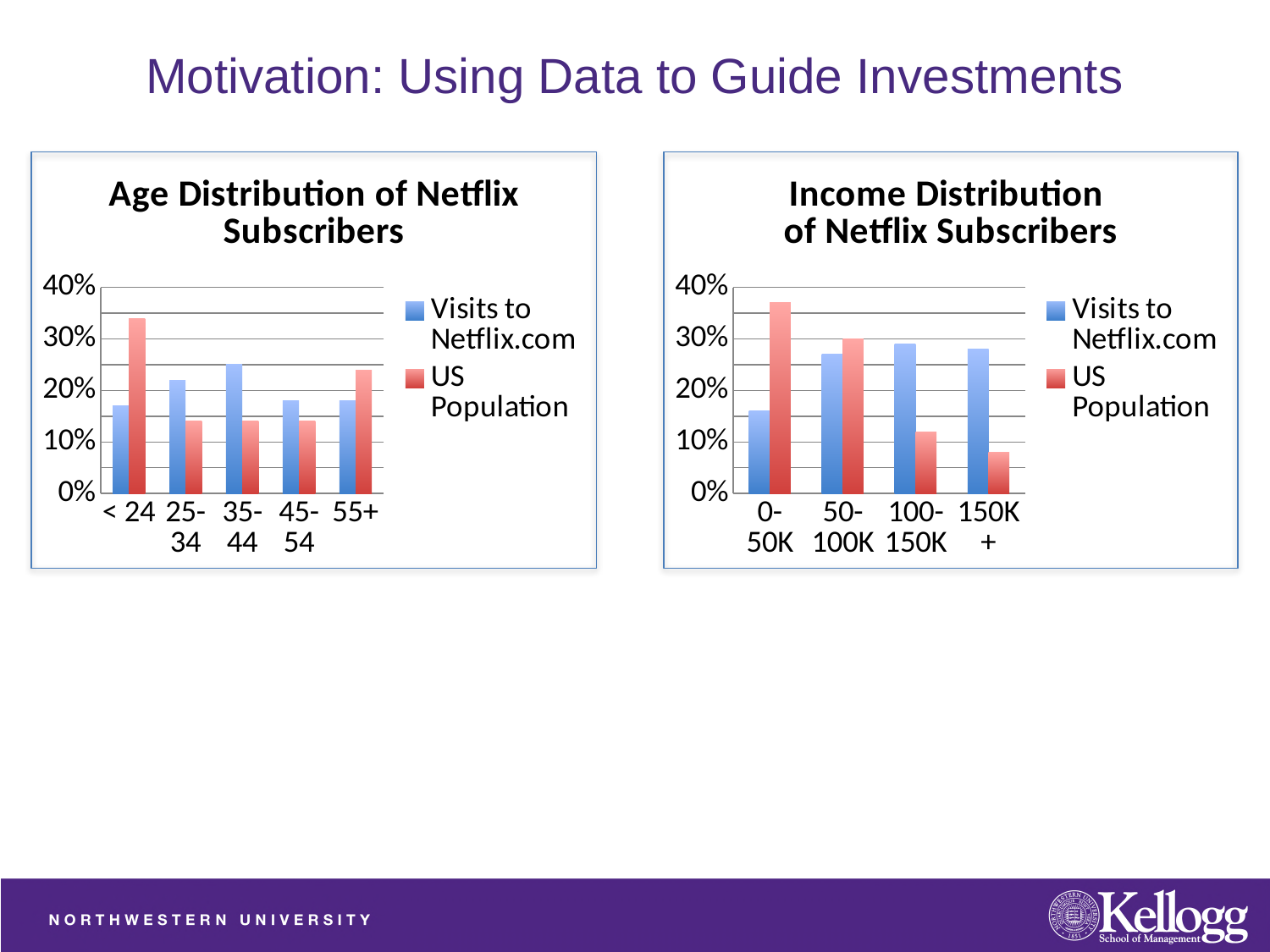
On the 'Age Distribution of Netflix Subscribers' chart, is the Visits to Netflix.com value for < 24 greater or less than 20%? less On the 'Income Distribution of Netflix Subscribers' chart, for the 150K+ group, which is larger: Visits to Netflix.com or US Population? Visits to Netflix.com On the 'Income Distribution of Netflix Subscribers' chart, which income group has the lowest US Population value? 150K+ How many age categories are shown on the 'Age Distribution of Netflix Subscribers' chart? 5 On the 'Age Distribution of Netflix Subscribers' chart, which age group has the highest US Population value? < 24 How many series does the legend of the 'Age Distribution of Netflix Subscribers' chart list? 2 What kind of chart is the 'Age Distribution of Netflix Subscribers' chart? bar chart On the 'Age Distribution of Netflix Subscribers' chart, which age group has the highest Visits to Netflix.com value? 35-44 On the 'Income Distribution of Netflix Subscribers' chart, is the US Population value for 0-50K greater or less than 30%? greater On the 'Income Distribution of Netflix Subscribers' chart, do the US Population values rise or fall as income increases? fall How many income categories are shown on the 'Income Distribution of Netflix Subscribers' chart? 4 On the 'Age Distribution of Netflix Subscribers' chart, for the < 24 group, which is larger: Visits to Netflix.com or US Population? US Population